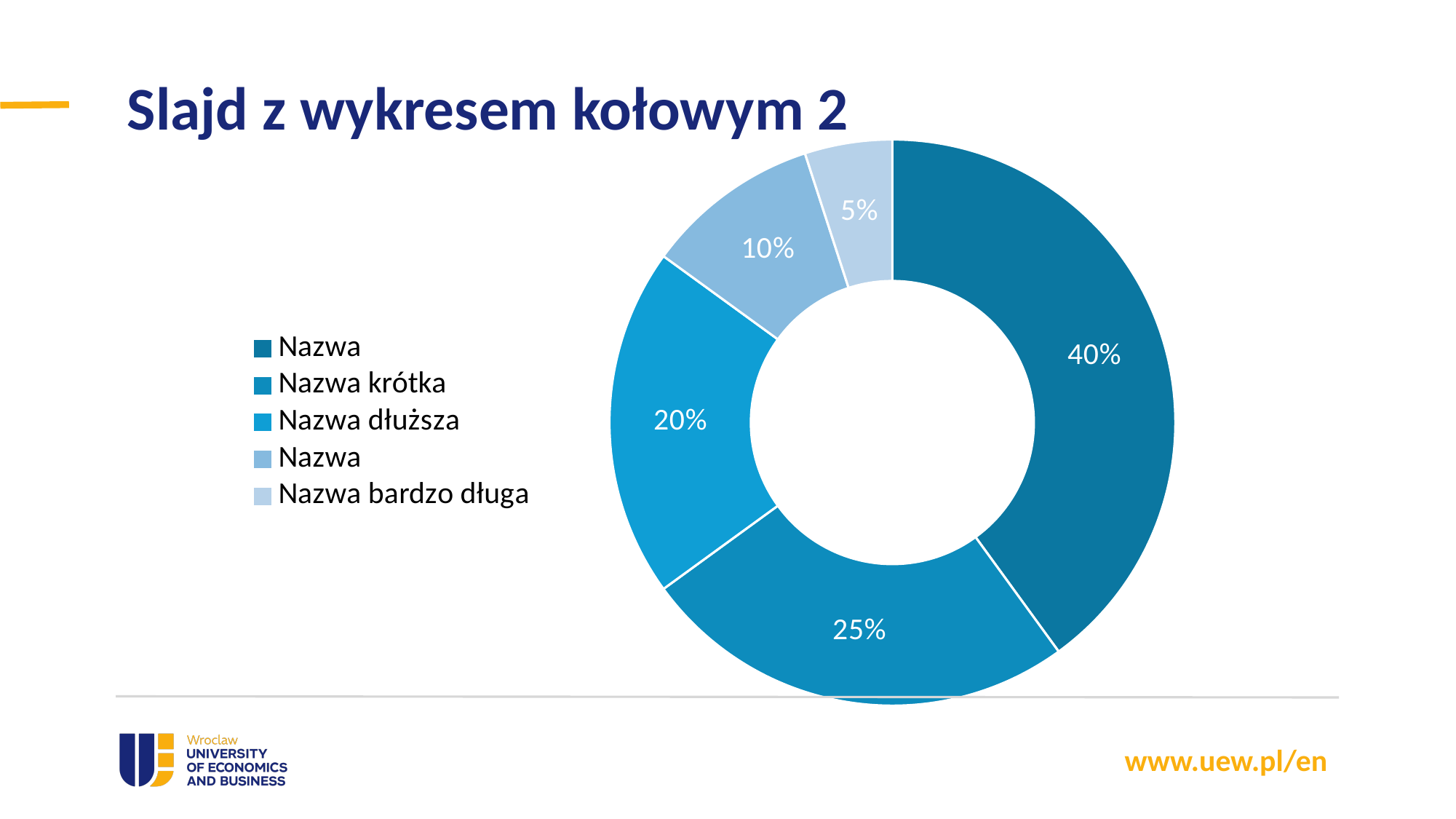
What kind of chart is shown on the slide? doughnut chart What is the combined share of the two smallest slices (10% and 5%)? 15% What percentage is shown for the slice labelled "Nazwa bardzo długa"? 5% Which slice is larger, "Nazwa krótka" or "Nazwa bardzo długa"? Nazwa krótka What percentage is shown for the slice labelled "Nazwa dłuższa"? 20% What is the difference in percentage points between the "Nazwa krótka" slice and the "Nazwa dłuższa" slice? 5 What percentage is shown for the slice labelled "Nazwa krótka"? 25% What is the largest percentage shown on the chart? 40% Which legend entry corresponds to the smallest slice of the chart? Nazwa bardzo długa How many slices does the chart have? 5 How many entries does the legend list? 5 What is the title of the slide containing the chart? Slajd z wykresem kołowym 2